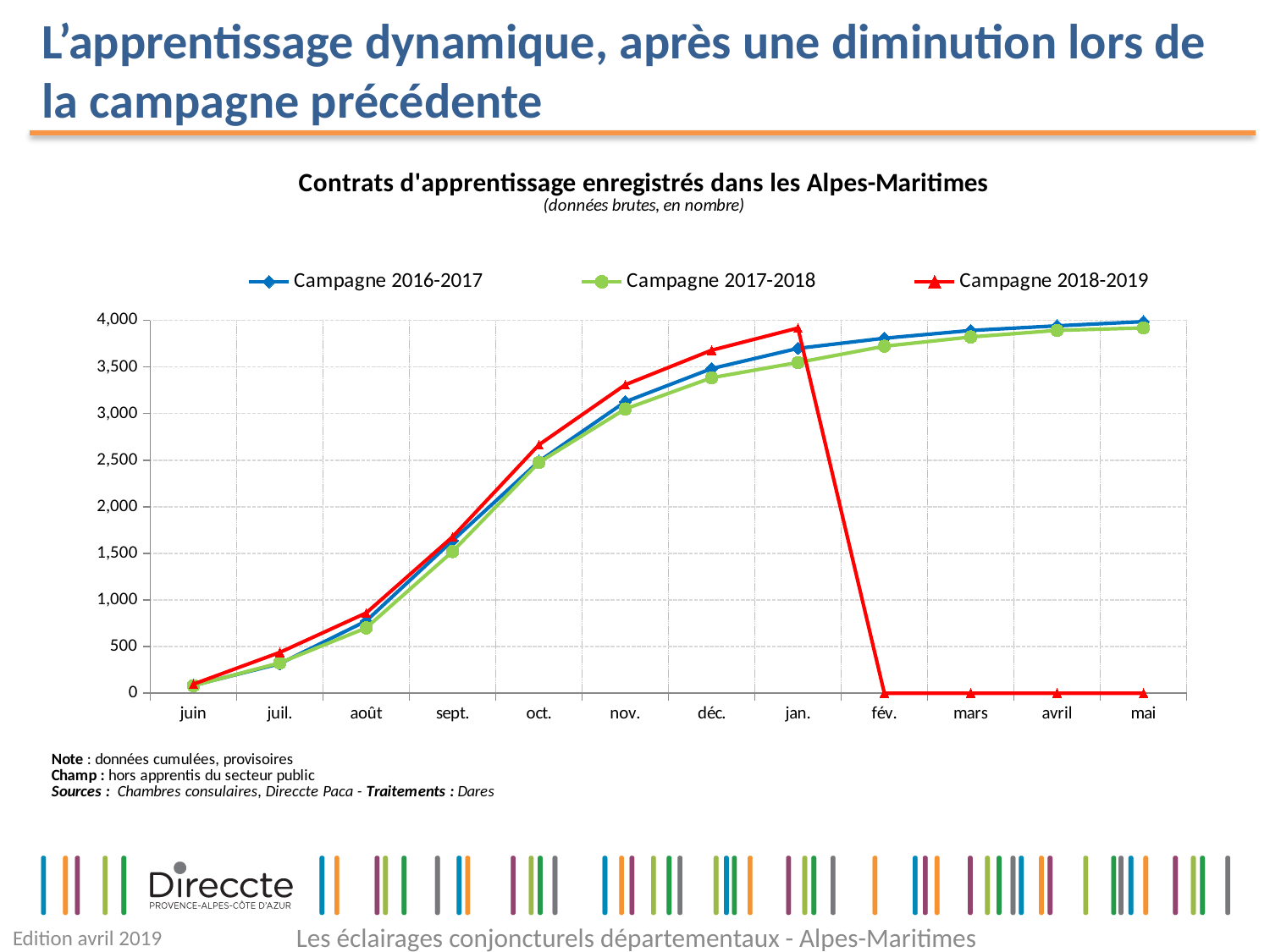
Is the value for Campagne 2017-2018 in mai greater or less than 3,500? greater Which campaign has the highest value in jan.? Campagne 2018-2019 Do the values for Campagne 2016-2017 rise or fall from juin to mai? rise Is the value for Campagne 2018-2019 in nov. greater or less than 3,000? greater How many months are shown along the x axis? 12 How many series does the legend list? 3 In déc., which is larger: Campagne 2016-2017 or Campagne 2017-2018? Campagne 2016-2017 What kind of chart is shown on the slide? line chart What colour is the line for Campagne 2018-2019? red Is the value for Campagne 2018-2019 in jan. greater or less than 3,500? greater Which campaign has the lowest value in jan.? Campagne 2017-2018